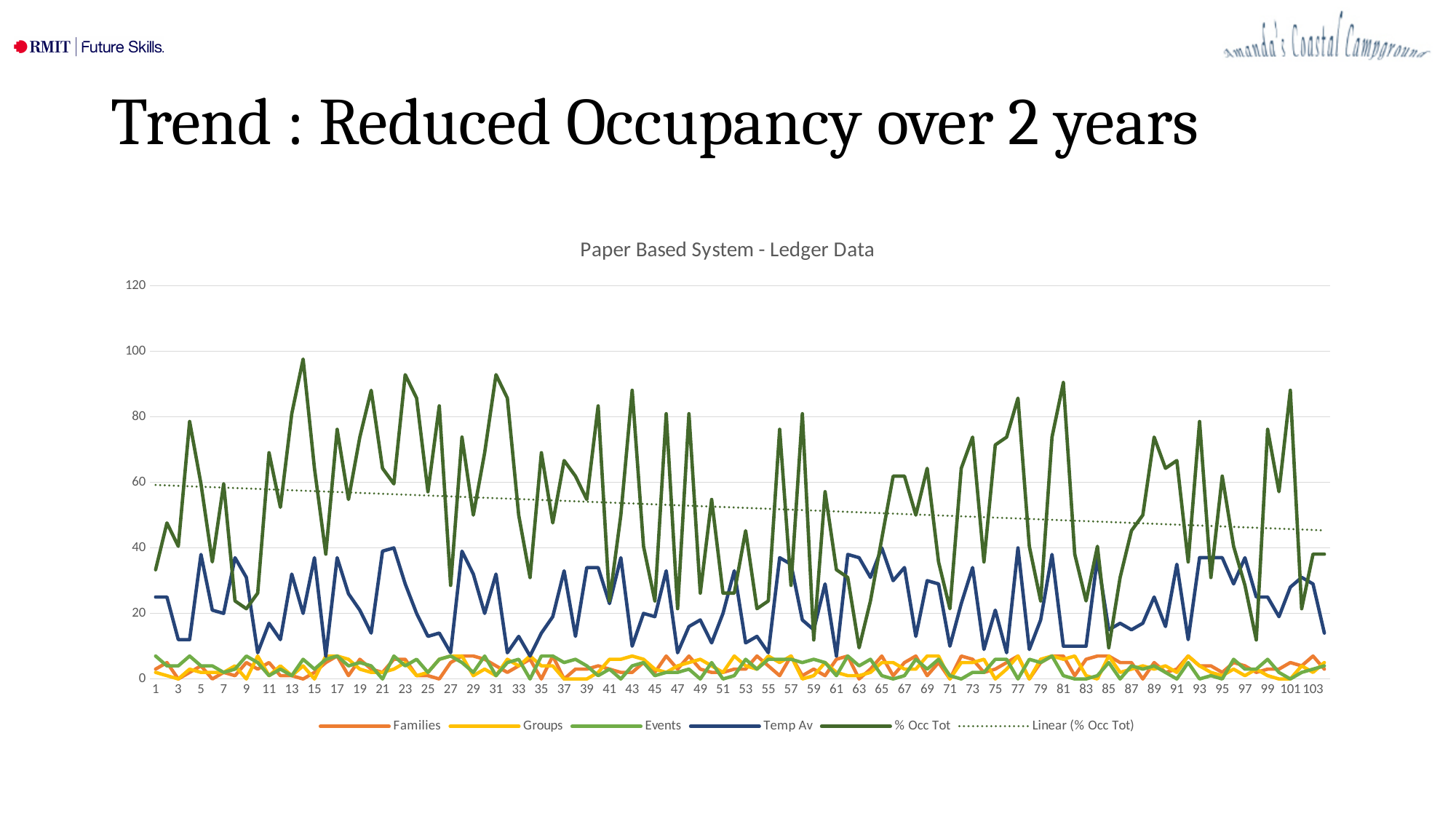
What kind of chart is shown on the slide? line chart What is the title of the chart? Paper Based System - Ledger Data How many entries does the chart legend list? 6 Is the value of Temp Av at point 1 greater or less than 40? less What is the highest value shown on the vertical axis? 120 Is the value of % Occ Tot at point 14 greater or less than 80? greater Does the Linear (% Occ Tot) trendline rise or fall from left to right along the x axis? fall At point 14, which is larger: % Occ Tot or Temp Av? % Occ Tot Which legend entry is drawn as a dotted line? Linear (% Occ Tot) Is the value of Families at point 1 greater or less than 20? less Which series reaches the highest values on the chart? % Occ Tot